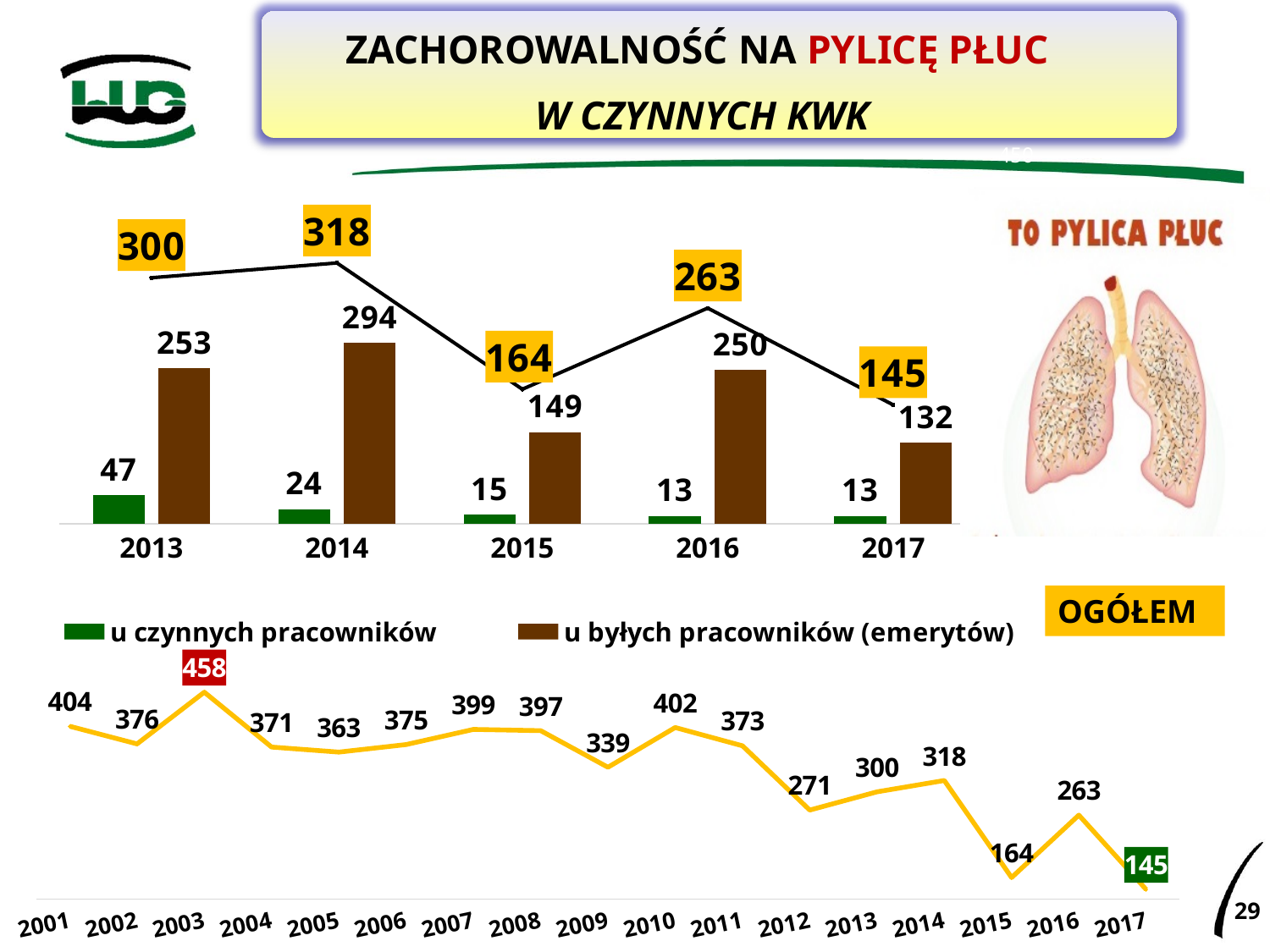
In the bottom OGÓŁEM line chart, which year has the highest value? 2003 In the bottom OGÓŁEM line chart, what is the difference between the values for 2003 and 2017? 313 In the top bar chart, how many years are shown on the x axis? 5 In the top bar chart, what is the value for 'u czynnych pracowników' in 2013? 47 In the top bar chart, which year has the highest value for 'u byłych pracowników (emerytów)'? 2014 In the top bar chart, what is the value for 'u byłych pracowników (emerytów)' in 2014? 294 In the top bar chart, what is the difference between the 'u byłych pracowników (emerytów)' and 'u czynnych pracowników' values in 2017? 119 In the top bar chart, how many series does the legend list? 2 In the top bar chart, what total value is shown in the yellow label for 2016? 263 In the bottom OGÓŁEM line chart, what is the value for 2009? 339 In the bottom OGÓŁEM line chart, which year has the lowest value? 2017 What kind of chart is the bottom OGÓŁEM chart? line chart